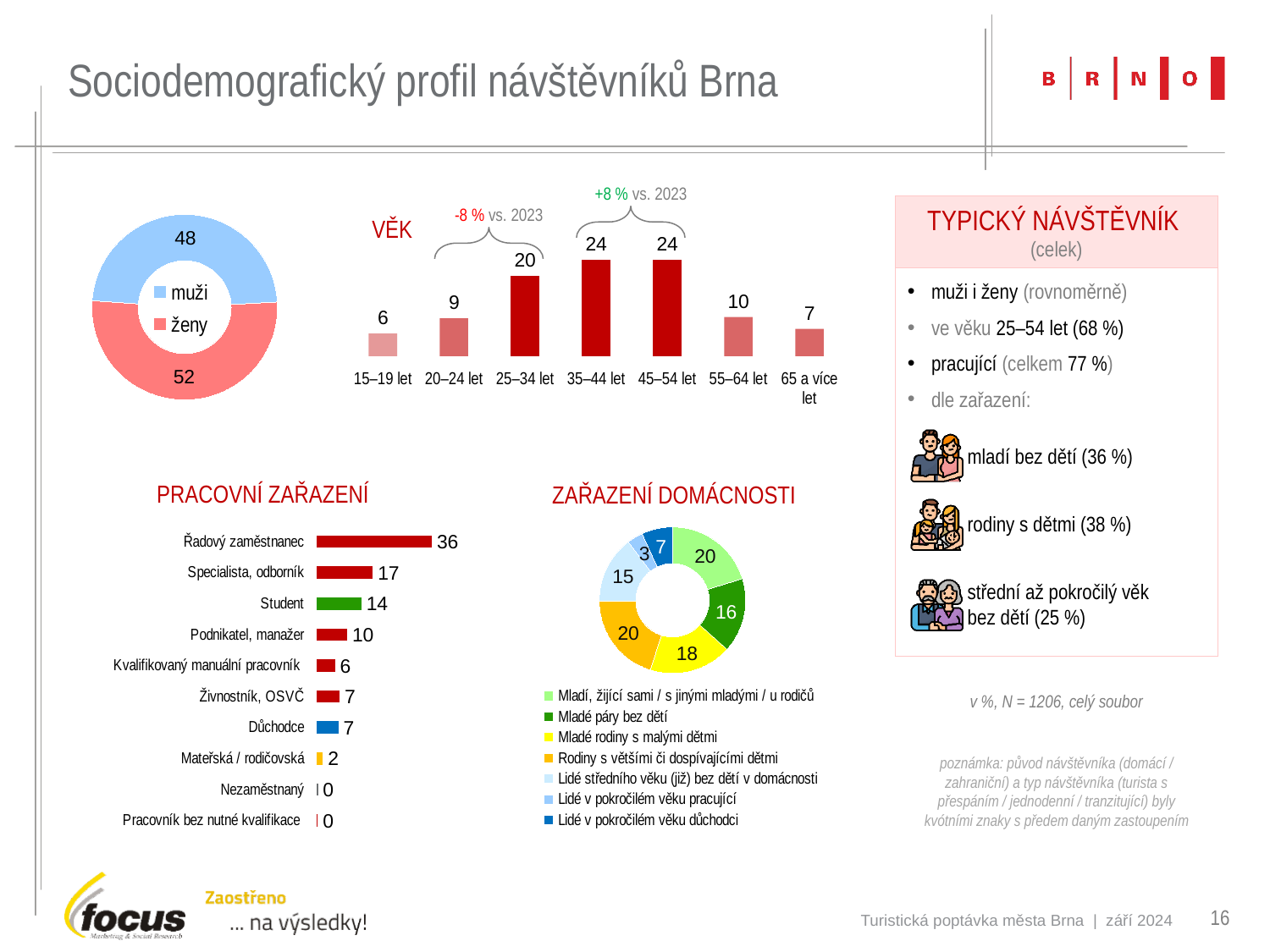
In the VĚK chart, what is the value for the 25–34 let category? 20 In the ZAŘAZENÍ DOMÁCNOSTI chart, how many categories does the legend list? 7 In the PRACOVNÍ ZAŘAZENÍ chart, which category has the highest value? Řadový zaměstnanec In the PRACOVNÍ ZAŘAZENÍ chart, what is the value for Student? 14 In the gender donut chart at the top left, what is the value for ženy? 52 In the VĚK chart, which age category has the lowest value? 15–19 let What kind of chart is the PRACOVNÍ ZAŘAZENÍ chart? bar chart In the VĚK chart, how many age categories are shown? 7 In the gender donut chart at the top left, how many series does the legend list? 2 In the VĚK chart, what is the difference between the values for 55–64 let and 65 a více let? 3 In the PRACOVNÍ ZAŘAZENÍ chart, which is larger: Specialista, odborník or Podnikatel, manažer? Specialista, odborník In the ZAŘAZENÍ DOMÁCNOSTI chart, what is the value for Mladé páry bez dětí? 16